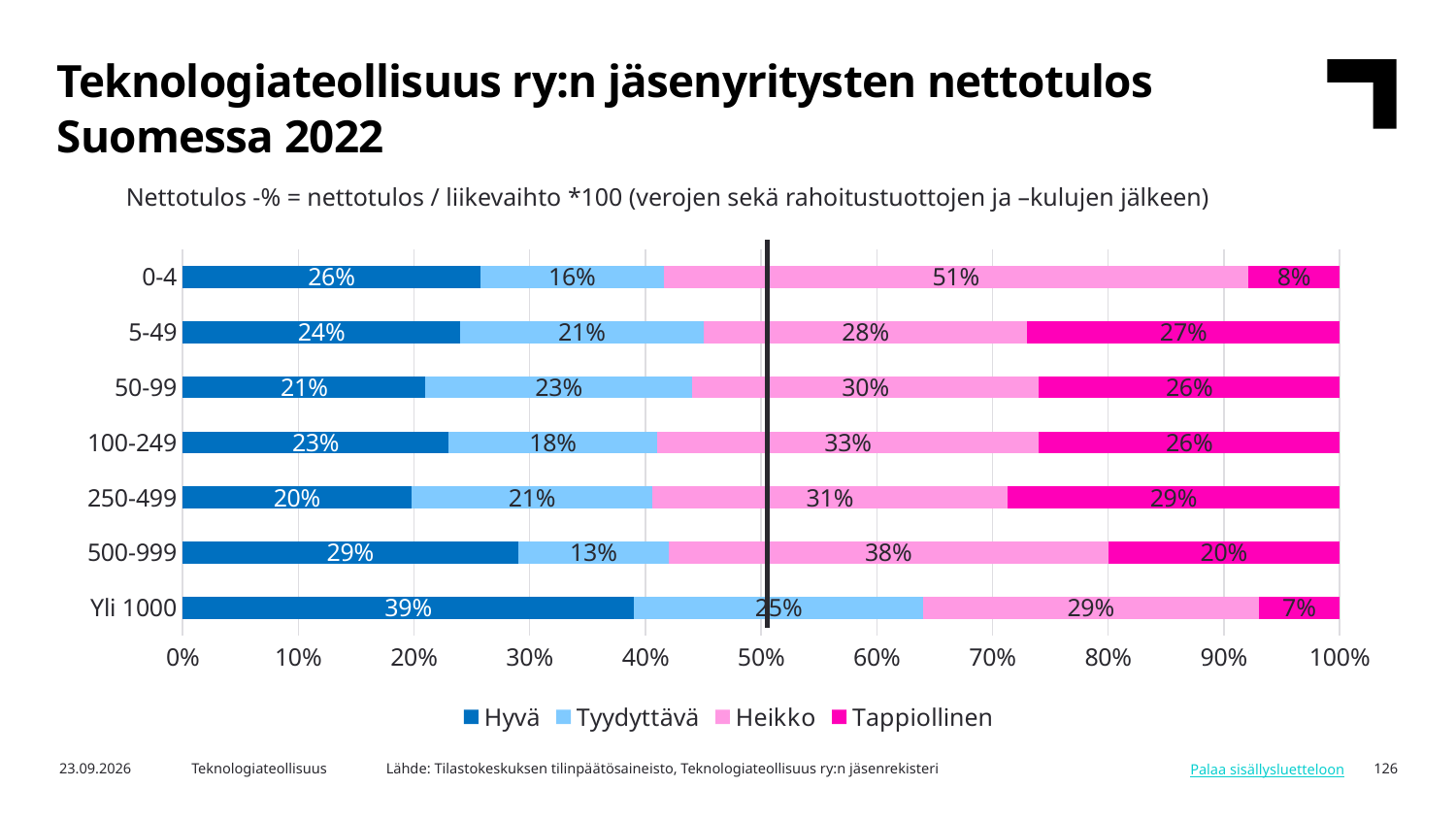
What is the Heikko share for the 0-4 category? 51% Which category has the highest Hyvä share? Yli 1000 What is the Tyydyttävä share for the 500-999 category? 13% Which category has the lowest Tappiollinen share? Yli 1000 How many company size categories are shown on the chart? 7 What kind of chart is shown on the slide? Stacked bar chart What is the difference between the Tappiollinen share for 5-49 and for 0-4? 19 percentage points How many series does the legend list? 4 Which is larger: the Heikko share for 500-999 or the Heikko share for 100-249? 500-999 What is the Tappiollinen share for the 250-499 category? 29% Which series is shown in the darkest blue colour in the legend? Hyvä What is the Hyvä share for the Yli 1000 category? 39%